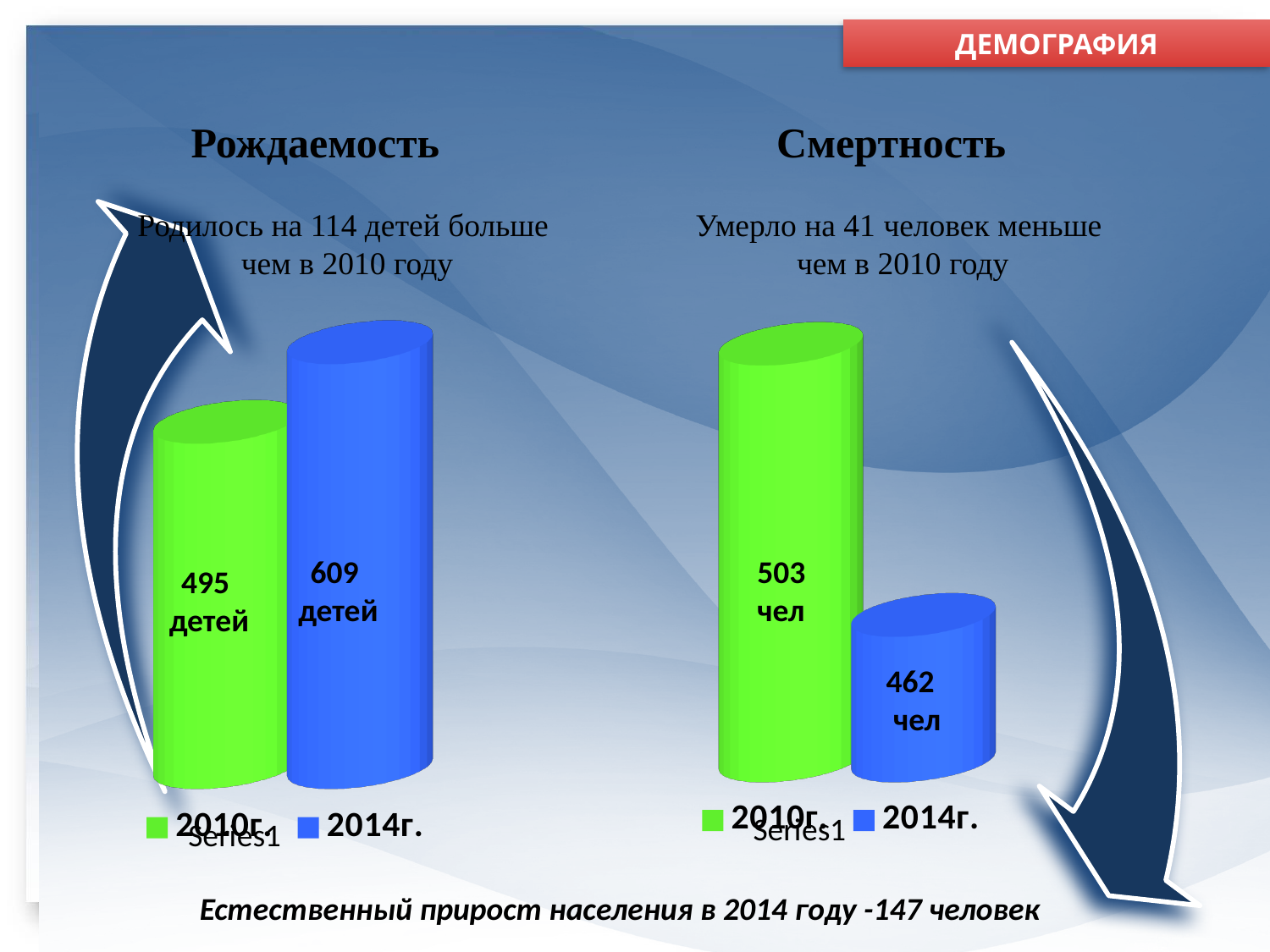
In the Рождаемость chart, which year has the higher value? 2014г. In the Рождаемость chart, what is the value for 2010г.? 495 детей In the Смертность chart, is the value for 2010г. larger or smaller than the value for 2014г.? larger In the Рождаемость chart, what is the difference between the 2014г. and 2010г. values? 114 In the Смертность chart, what is the value for 2010г.? 503 чел In the Смертность chart, what is the value for 2014г.? 462 чел In the Рождаемость chart, what is the value for 2014г.? 609 детей What kind of chart is the Смертность chart? bar chart In the Смертность chart, what is the difference between the 2010г. and 2014г. values? 41 How many entries does the legend of the Рождаемость chart list? 2 In the Смертность chart, which year has the lower value? 2014г. In the Смертность chart, which colour represents 2014г.? blue